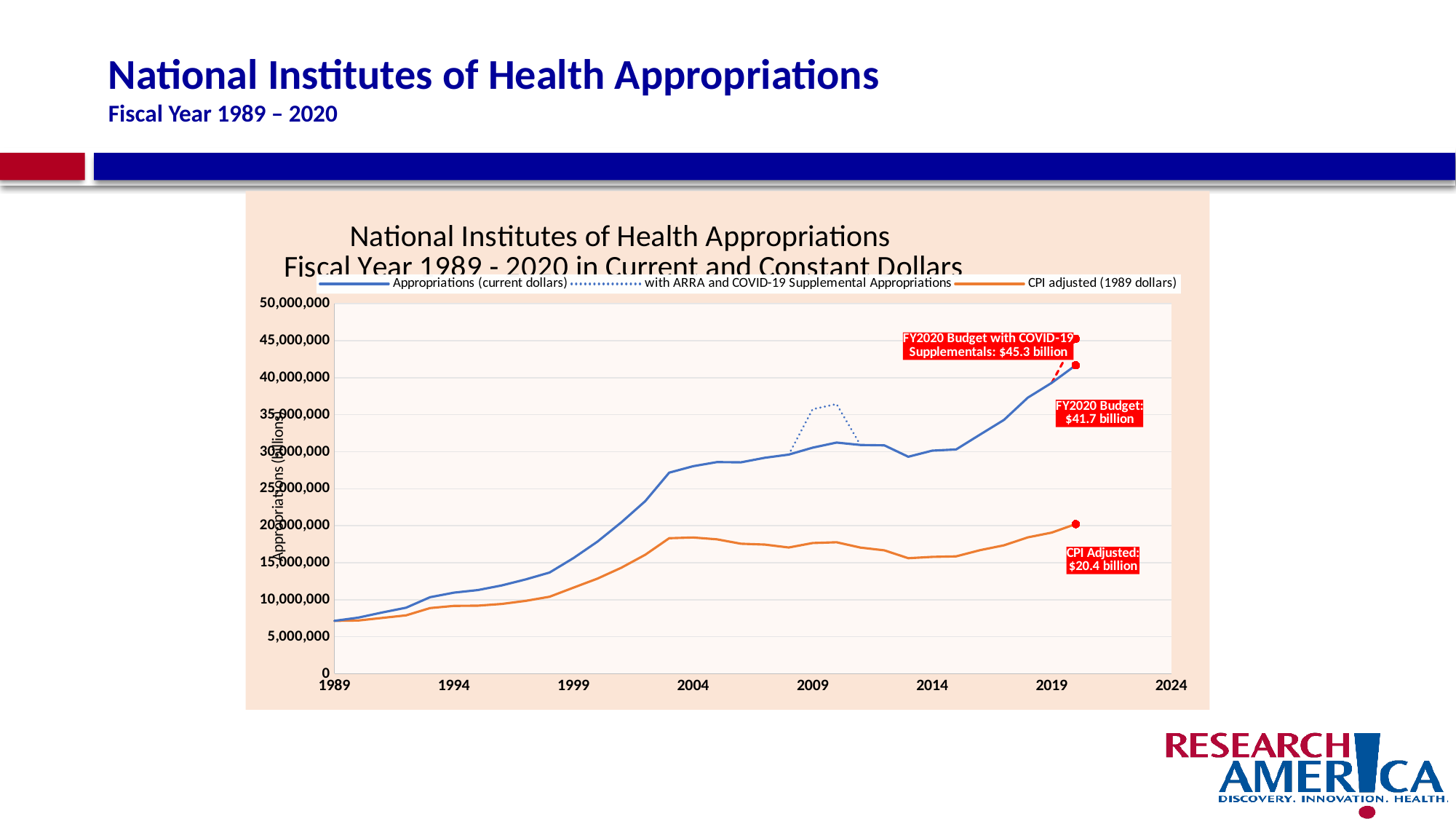
Is the CPI adjusted (1989 dollars) value in 2004 greater or less than 20,000,000? less How many series does the chart legend list? 3 Is the Appropriations (current dollars) value in 2004 greater or less than 25,000,000? greater What is the FY2020 Budget with COVID-19 Supplementals value labelled on the chart? $45.3 billion In 2019, which series is higher: Appropriations (current dollars) or CPI adjusted (1989 dollars)? Appropriations (current dollars) What is the CPI Adjusted value labelled on the chart for FY2020? $20.4 billion Does the CPI adjusted (1989 dollars) line rise or fall between 1989 and 2004? Rise What is the FY2020 Budget value labelled on the chart? $41.7 billion What kind of chart is shown on the slide? Line chart How much larger is the FY2020 Budget with COVID-19 Supplementals than the FY2020 Budget? $3.6 billion What is the difference between the FY2020 Budget and the FY2020 CPI Adjusted value? $21.3 billion What is the label of the dotted series in the legend? with ARRA and COVID-19 Supplemental Appropriations